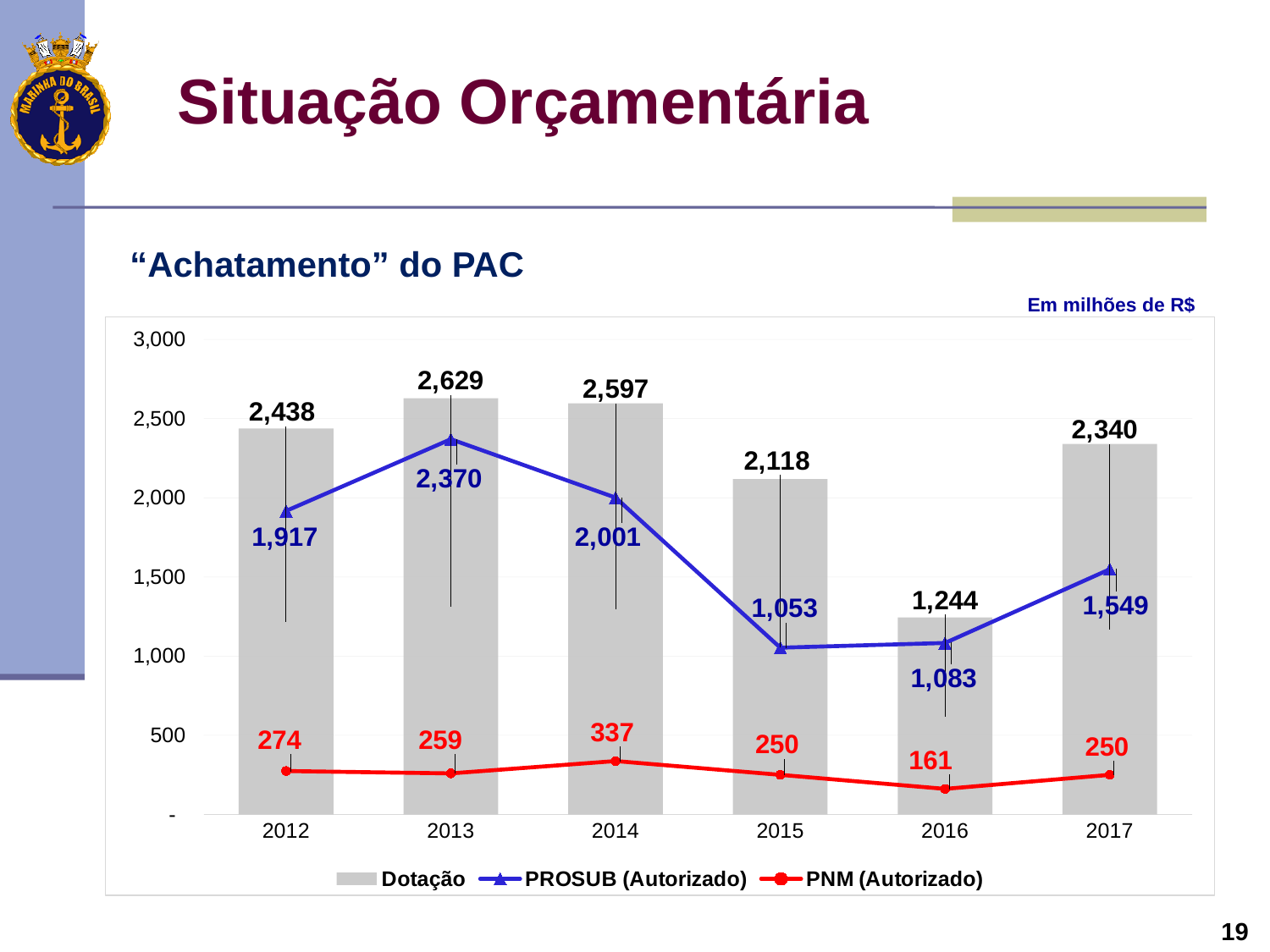
In which year is the Dotação highest? 2013 What is the PROSUB (Autorizado) value for 2015? 1,053 In which year is the PNM (Autorizado) value lowest? 2016 Which is larger, the PROSUB (Autorizado) value for 2012 or for 2017? 2012 How many years are shown on the x axis? 6 What is the difference between the Dotação values for 2014 and 2015? 479 How does the PROSUB (Autorizado) value change from 2013 to 2016? It falls What is the PNM (Autorizado) value for 2014? 337 What is the Dotação value for 2013? 2,629 How many series does the legend list? 3 Is the Dotação value for 2016 greater or less than 1,000? greater What unit is stated above the chart? Em milhões de R$